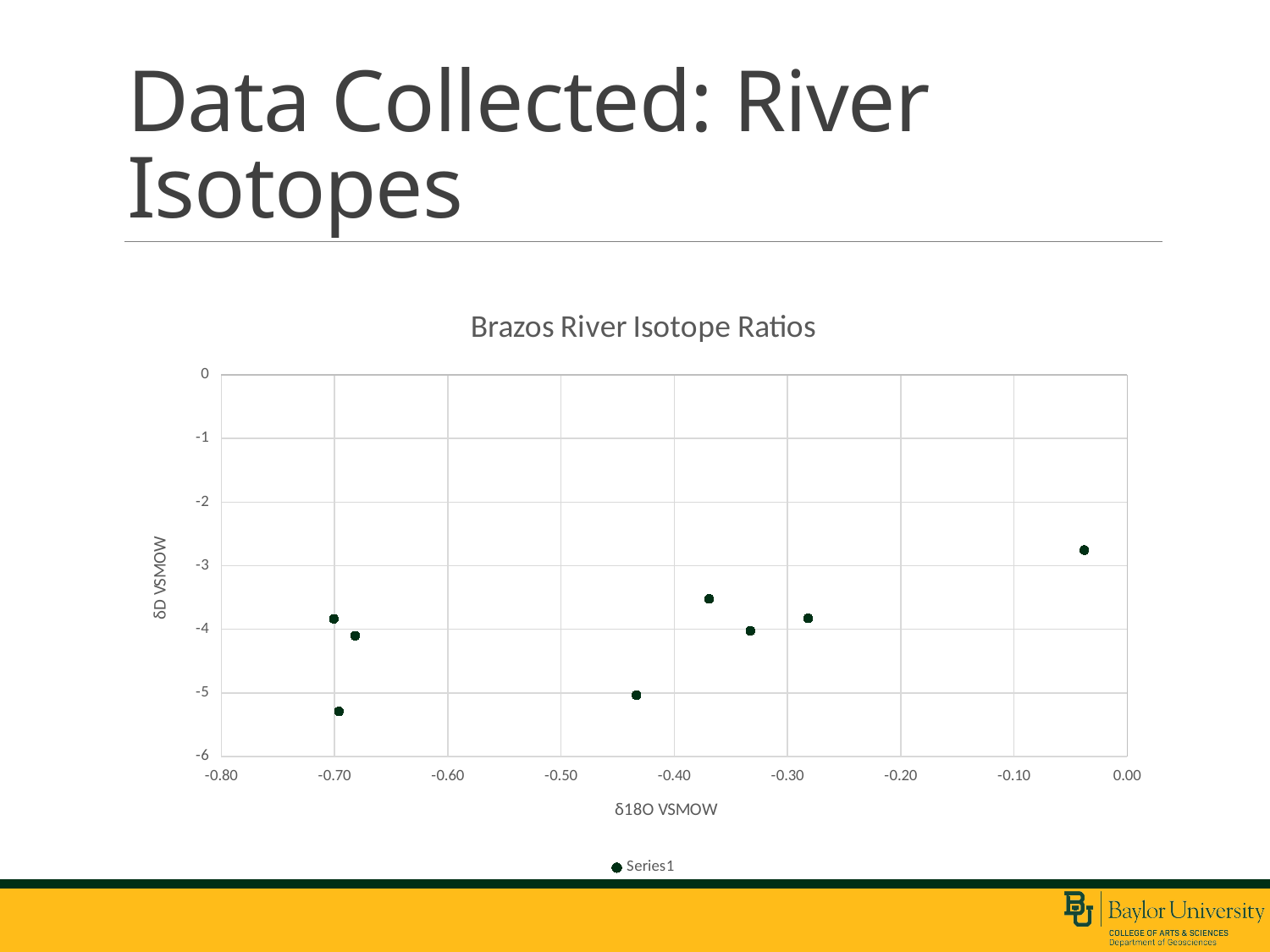
Is the δD value of the point near δ18O = -0.28 greater or less than -4? greater What is the name of the series shown in the legend? Series1 Is the δD value of the point with the highest δ18O (near 0.00) greater or less than -3? greater Is the δD value of the point near δ18O = -0.37 greater or less than -4? greater How many data points are plotted in the chart? 8 Do the δD values generally rise or fall as δ18O increases along the x axis? rise How many series does the legend list? 1 What is the title of the chart? Brazos River Isotope Ratios Which point has the highest δD value: the one near δ18O = -0.04 or the one near δ18O = -0.37? the one near δ18O = -0.04 What kind of chart is shown on the slide? scatter chart